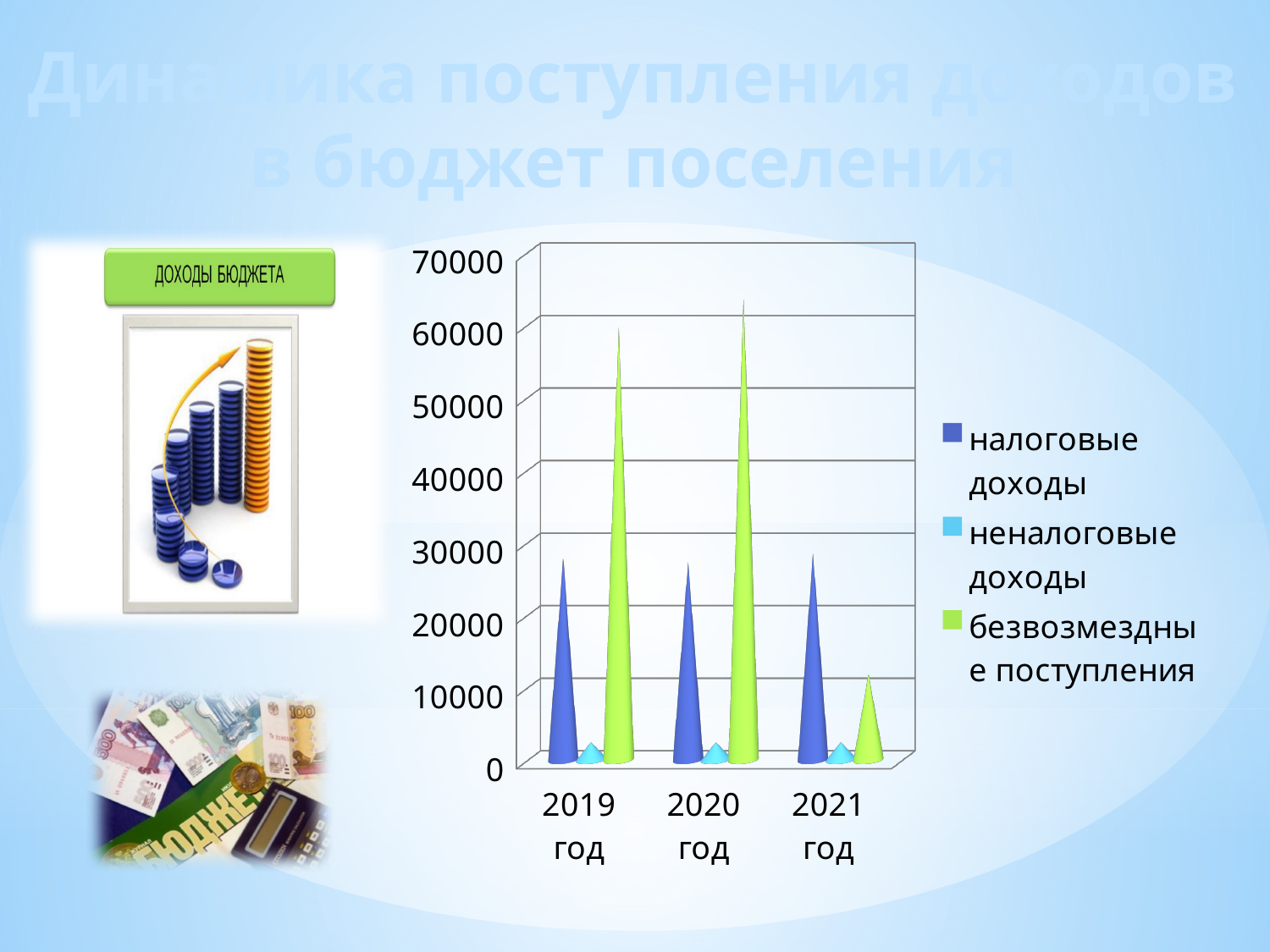
How many years (categories) are shown on the x axis of the chart? 3 Is the value for налоговые доходы in 2020 год greater or less than 30000? less In which year is the value for безвозмездные поступления the highest? 2020 год Which series has the lowest value in 2019 год? неналоговые доходы Which is larger in 2021 год: налоговые доходы or безвозмездные поступления? налоговые доходы Which colour represents неналоговые доходы in the chart legend? light blue (cyan) How many series does the chart legend list? 3 In which year is the value for безвозмездные поступления the lowest? 2021 год Is the value for безвозмездные поступления in 2019 год greater or less than 50000? greater Which series has the highest value in 2020 год? безвозмездные поступления What kind of chart is shown on the slide? bar chart Is the value for безвозмездные поступления in 2021 год greater or less than 20000? less